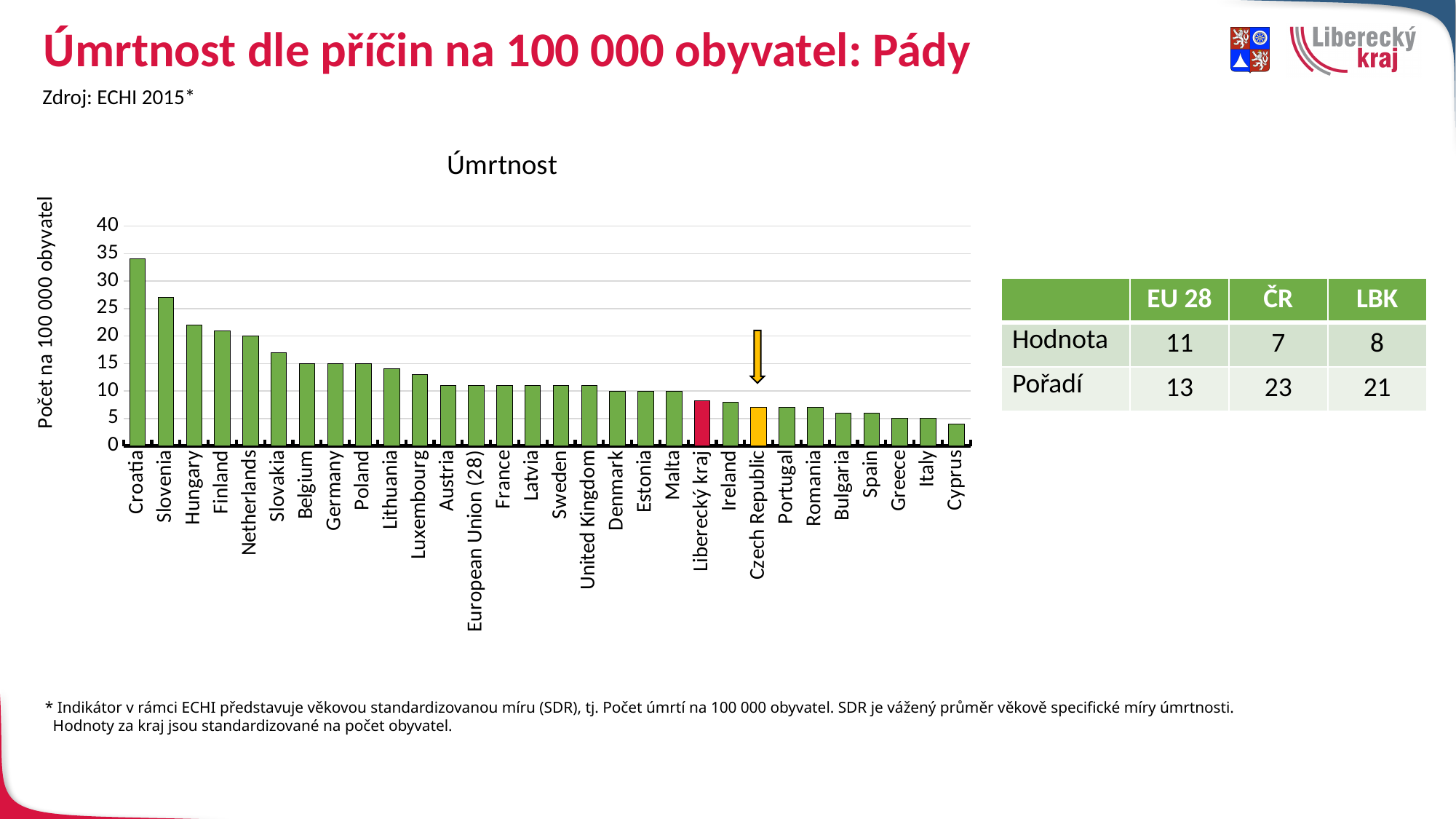
Which country has the lowest value in the chart? Cyprus What type of chart is shown on the slide? bar chart Which country has the highest value in the chart? Croatia Is the value for Cyprus greater or less than 5? less What is the value for Liberecký kraj according to the slide? 8 Do the values rise or fall from left to right along the x axis? fall Is the value for Croatia greater or less than 30? greater How many bars (categories) are plotted in the chart? 30 What colour is the bar for Czech Republic? yellow What is the value for Czech Republic according to the slide? 7 What is the difference between the value for European Union (28) and the value for Czech Republic? 4 What is the value for European Union (28) according to the slide? 11